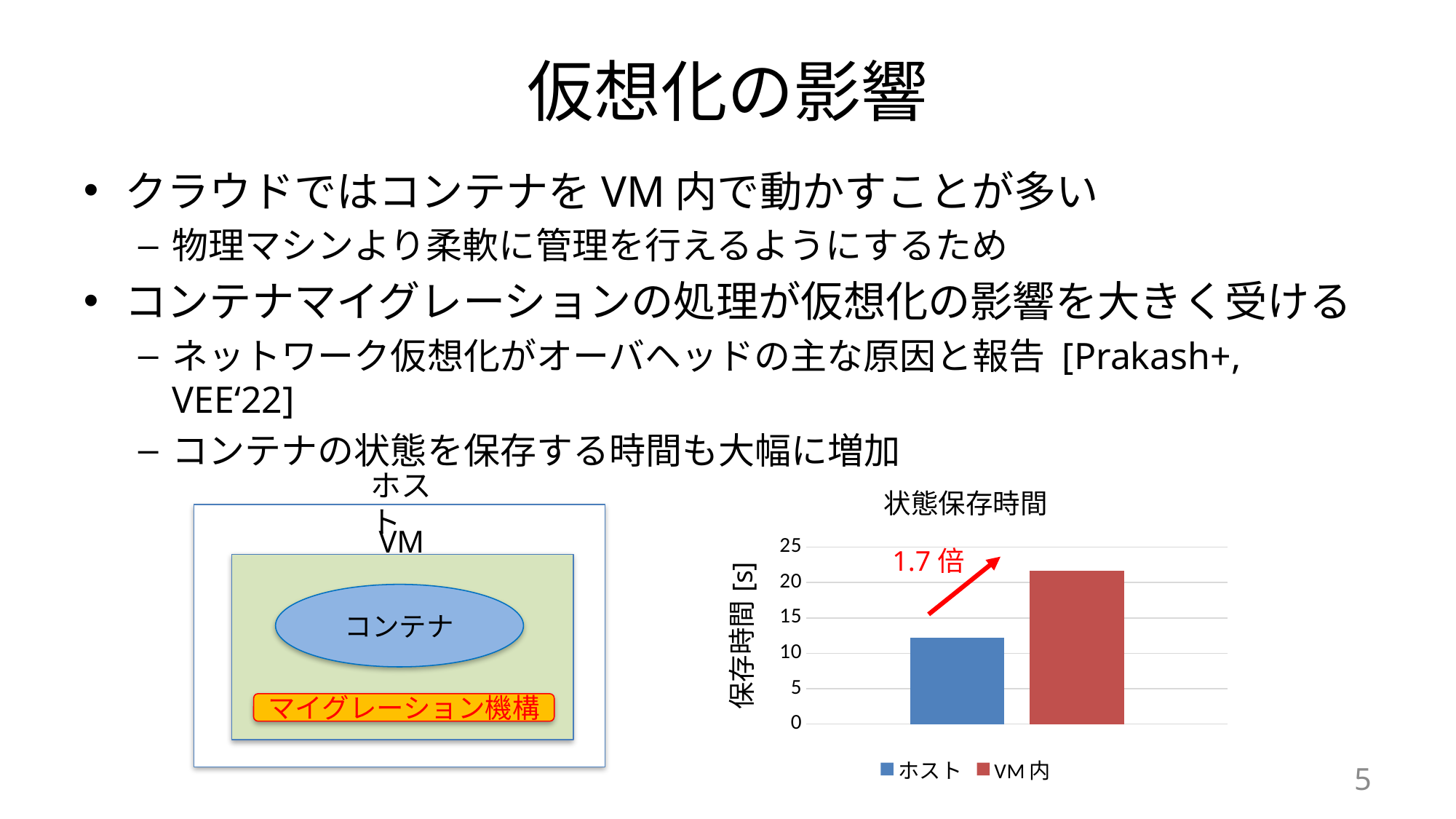
In the 状態保存時間 chart, is the value for VM 内 greater or less than 20? greater Which series has the highest value in the 状態保存時間 chart? VM 内 What kind of chart is shown under the title 状態保存時間? bar chart What ratio is written in red next to the arrow in the 状態保存時間 chart? 1.7 倍 In the 状態保存時間 chart, is the value for ホスト greater or less than 15? less In the 状態保存時間 chart, which is larger: the value for ホスト or the value for VM 内? VM 内 What is the label of the vertical axis of the 状態保存時間 chart? 保存時間 [s] Which series has the lowest value in the 状態保存時間 chart? ホスト How many series does the legend of the 状態保存時間 chart list? 2 In the 状態保存時間 chart, is the value for ホスト greater or less than 10? greater